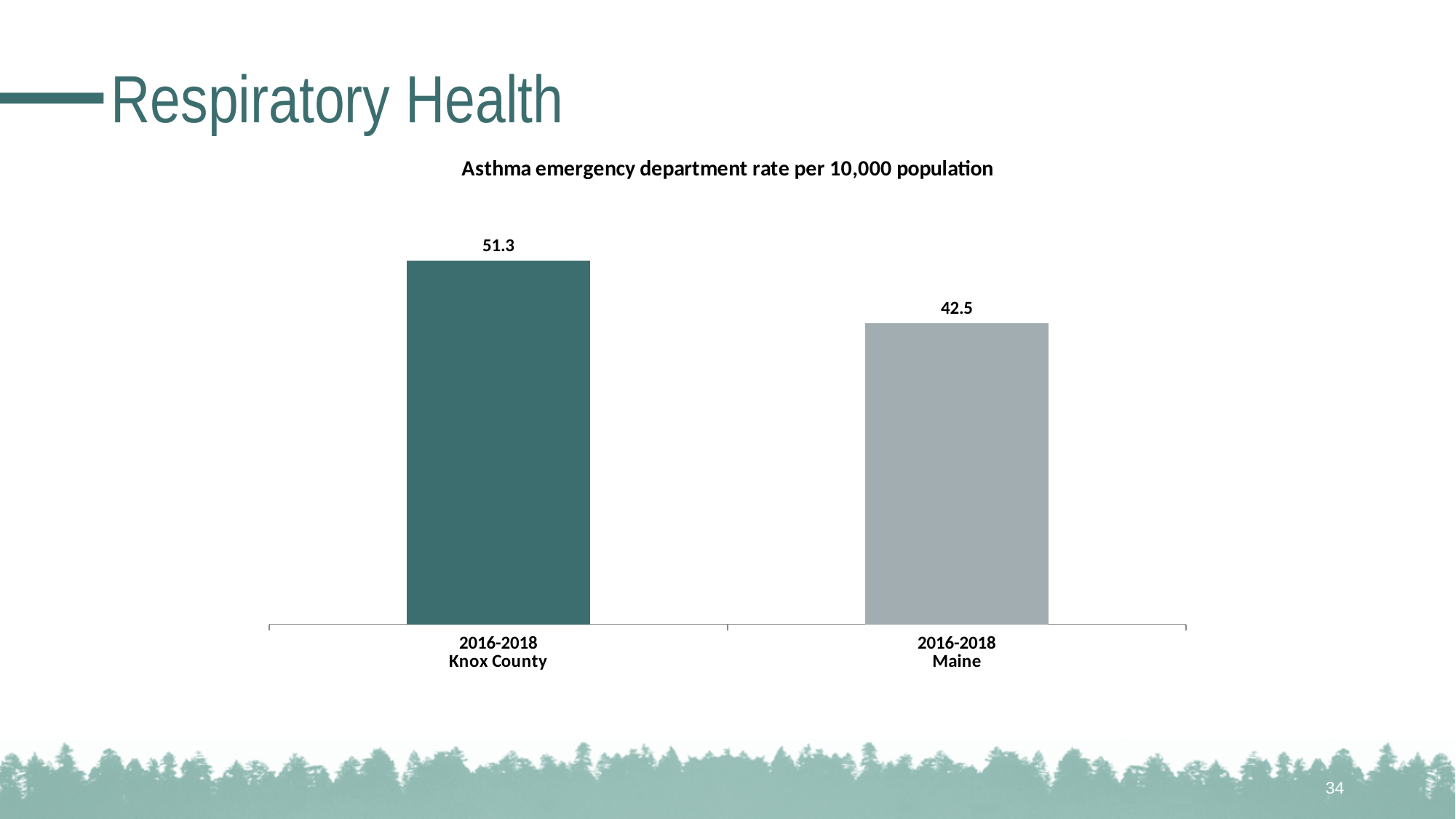
Which category has the lowest asthma emergency department rate? Maine How many bars are shown in the chart? 2 What is the title of the chart? Asthma emergency department rate per 10,000 population What is the asthma emergency department rate per 10,000 population for Knox County (2016-2018)? 51.3 What time period do both bars in the chart cover? 2016-2018 Is the asthma emergency department rate for Maine larger or smaller than that for Knox County? smaller What is the asthma emergency department rate per 10,000 population for Maine (2016-2018)? 42.5 Which category has the higher asthma emergency department rate, Knox County or Maine? Knox County What is the difference between the Knox County and Maine asthma emergency department rates? 8.8 What kind of chart is shown on the slide? bar chart